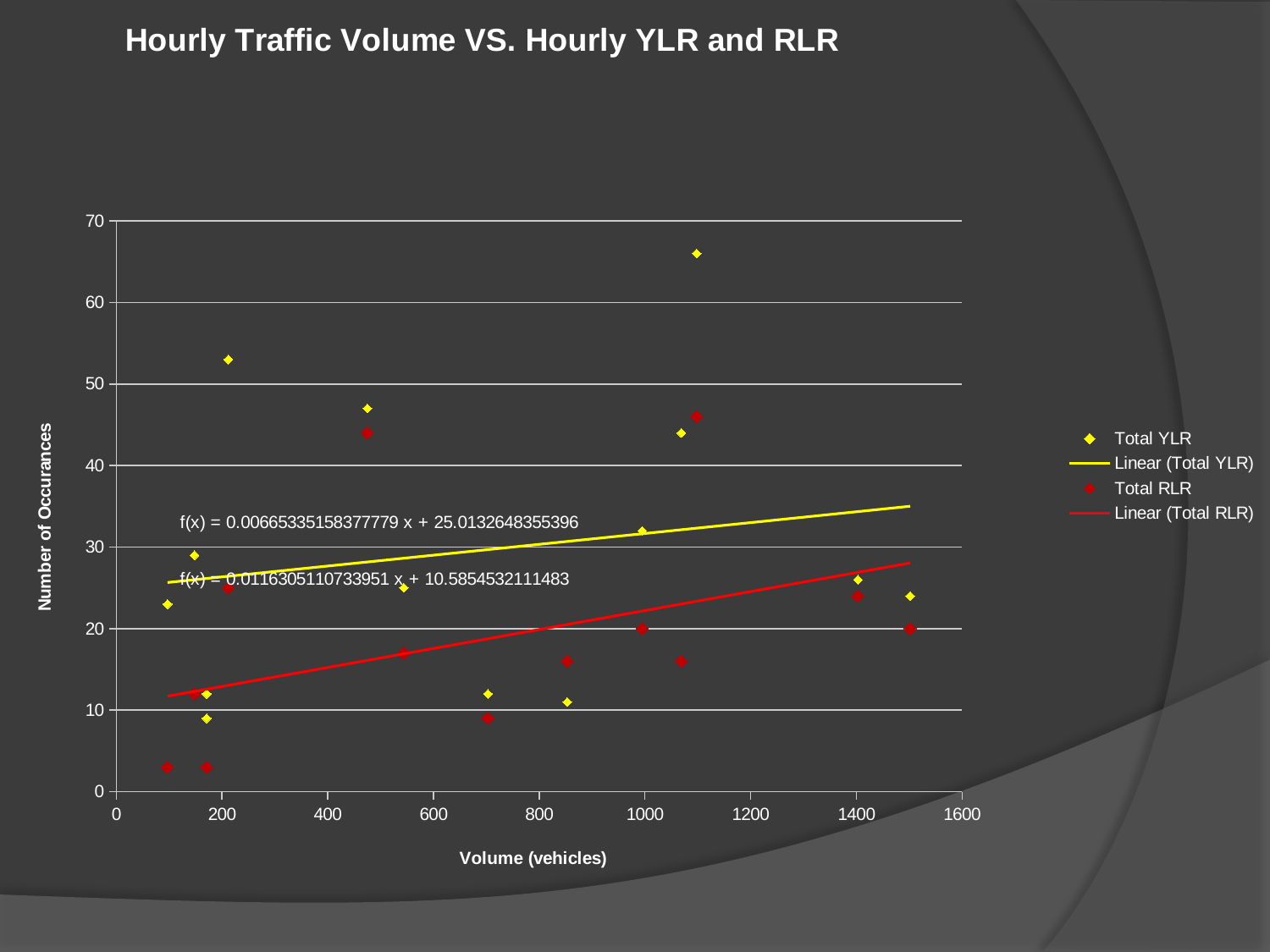
Which trendline has the larger slope, Linear (Total YLR) or Linear (Total RLR)? Linear (Total RLR) Is the Total RLR point at a volume of about 1500 vehicles greater or less than 30 occurrences? less Do the Linear (Total RLR) trendline values rise or fall as volume increases? Rise What is the slope in the trendline equation for Total YLR? 0.00665335158377779 Which series has the highest single point on the chart, Total YLR or Total RLR? Total YLR Is the highest Total YLR point greater or less than 60 occurrences? greater What is the intercept in the trendline equation for Total RLR? 10.5854532111483 What kind of chart is shown on the slide? Scatter chart Is the lowest Total RLR point greater or less than 10 occurrences? less What is the label of the x axis? Volume (vehicles) How many entries does the legend list? 4 What is the title of the chart? Hourly Traffic Volume VS. Hourly YLR and RLR